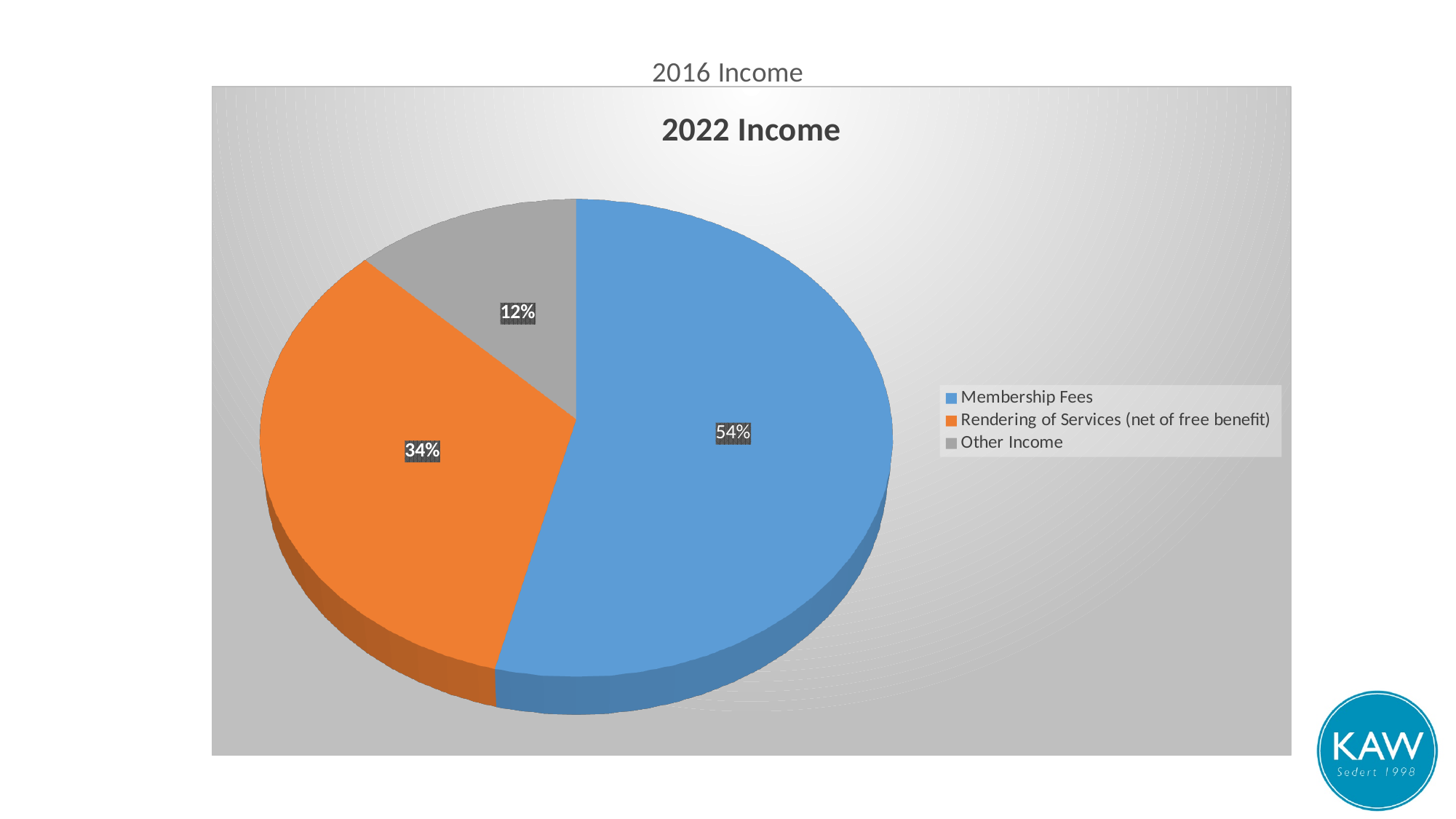
What share of 2022 Income comes from Other Income? 12% Which colour represents Other Income in the pie chart? Grey What share of 2022 Income comes from Membership Fees? 54% What is the title shown inside the chart area? 2022 Income Which category has the smallest share of 2022 Income? Other Income What is the difference in percentage points between the Rendering of Services share and the Other Income share? 22 Which category has the largest share of 2022 Income? Membership Fees What is the difference in percentage points between the Membership Fees share and the Rendering of Services share? 20 How many categories are shown in the pie chart? 3 Which is larger: the share for Rendering of Services (net of free benefit) or the share for Other Income? Rendering of Services (net of free benefit) What kind of chart is shown on the slide? Pie chart What share of 2022 Income comes from Rendering of Services (net of free benefit)? 34%